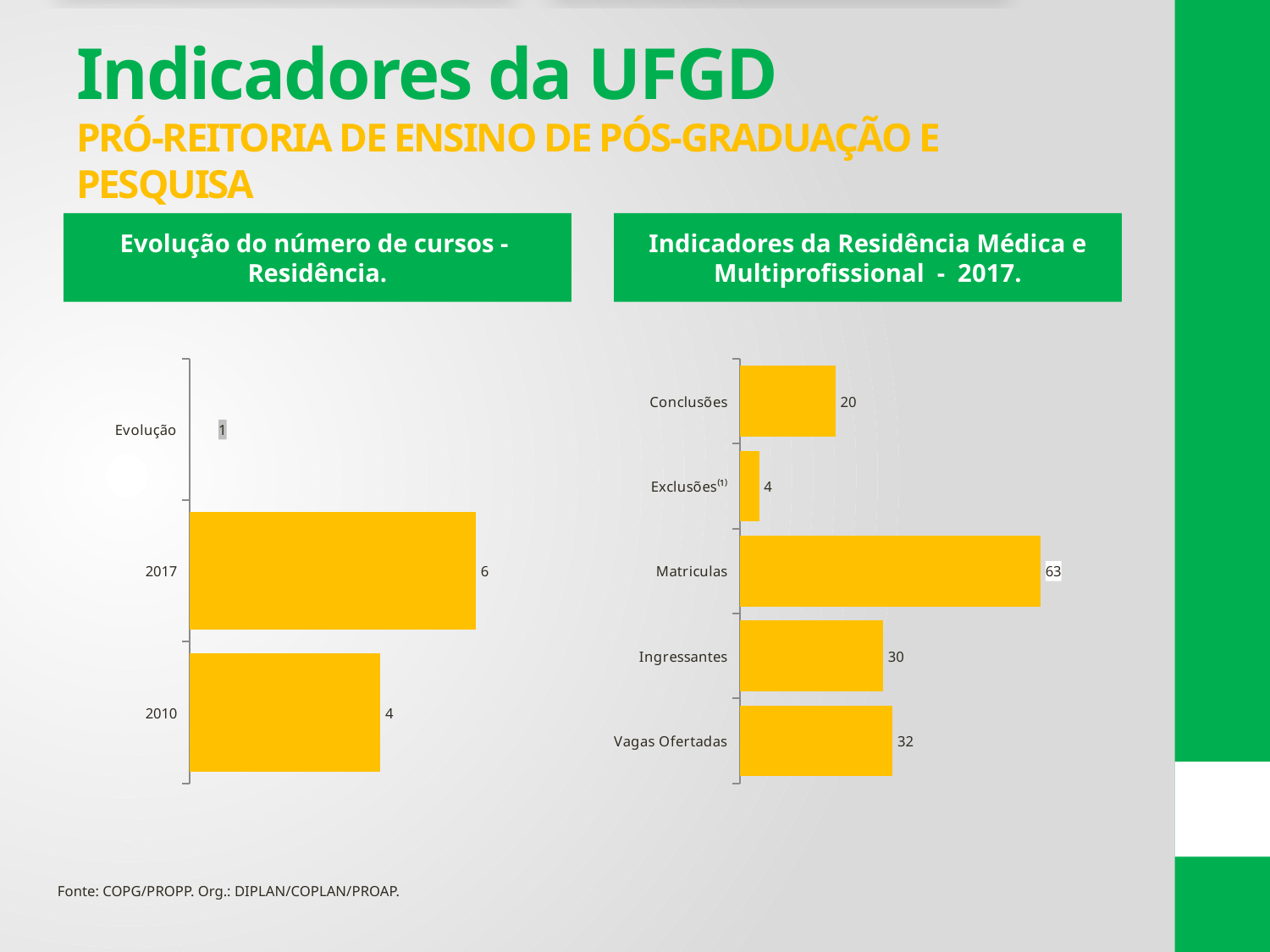
In the chart 'Indicadores da Residência Médica e Multiprofissional - 2017', which category has the highest value? Matriculas In the chart 'Indicadores da Residência Médica e Multiprofissional - 2017', what is the difference between Vagas Ofertadas and Ingressantes? 2 What type of chart is the chart 'Indicadores da Residência Médica e Multiprofissional - 2017'? Bar chart In the chart 'Evolução do número de cursos - Residência', what is the value for 2010? 4 In the chart 'Evolução do número de cursos - Residência', what is the difference between the values for 2017 and 2010? 2 In the chart 'Indicadores da Residência Médica e Multiprofissional - 2017', what is the value for Vagas Ofertadas? 32 In the chart 'Indicadores da Residência Médica e Multiprofissional - 2017', what is the value for Matriculas? 63 In the chart 'Indicadores da Residência Médica e Multiprofissional - 2017', which category has the lowest value? Exclusões How many categories are shown in the chart 'Indicadores da Residência Médica e Multiprofissional - 2017'? 5 In the chart 'Indicadores da Residência Médica e Multiprofissional - 2017', which is larger, Conclusões or Ingressantes? Ingressantes In the chart 'Evolução do número de cursos - Residência', what is the value for 2017? 6 In the chart 'Evolução do número de cursos - Residência', what is the value labelled for 'Evolução'? 1